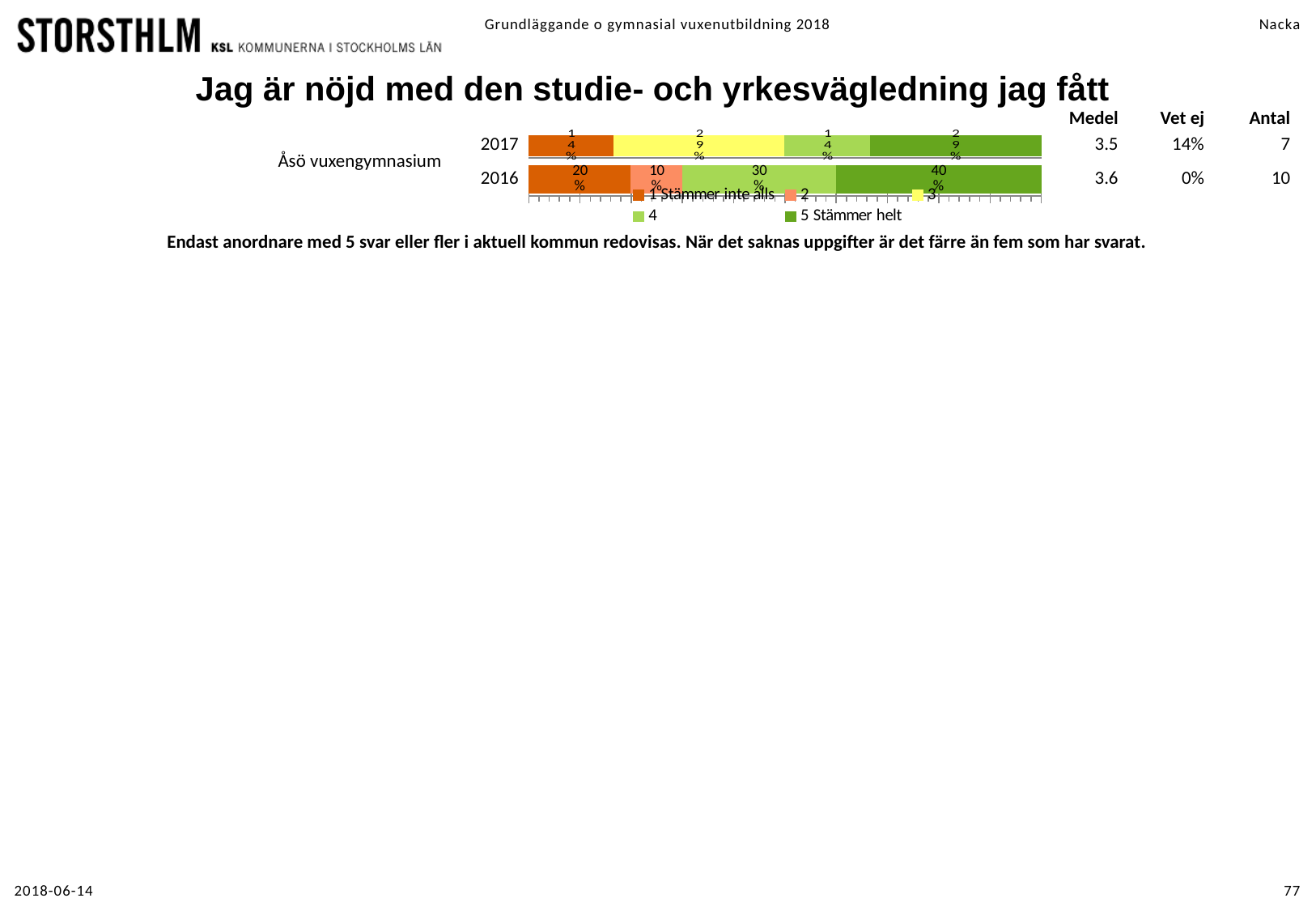
What share of the 2016 bar is '5 Stämmer helt'? 40% Which segment is the largest in the 2016 bar? 5 Stämmer helt Which is larger in 2016: the '4' segment or the '2' segment? 4 What share of the 2016 bar is category '2'? 10% How many series does the legend list? 5 What share of the 2016 bar is '1 Stämmer inte alls'? 20% What kind of chart is shown on the slide? stacked bar chart What share of the 2017 bar is '1 Stämmer inte alls'? 14% How many bars (years) are plotted for Åsö vuxengymnasium? 2 What share of the 2016 bar is category '4'? 30% What is the difference between the '5 Stämmer helt' share in 2016 and in 2017? 11 percentage points What share of the 2017 bar is '5 Stämmer helt'? 29%